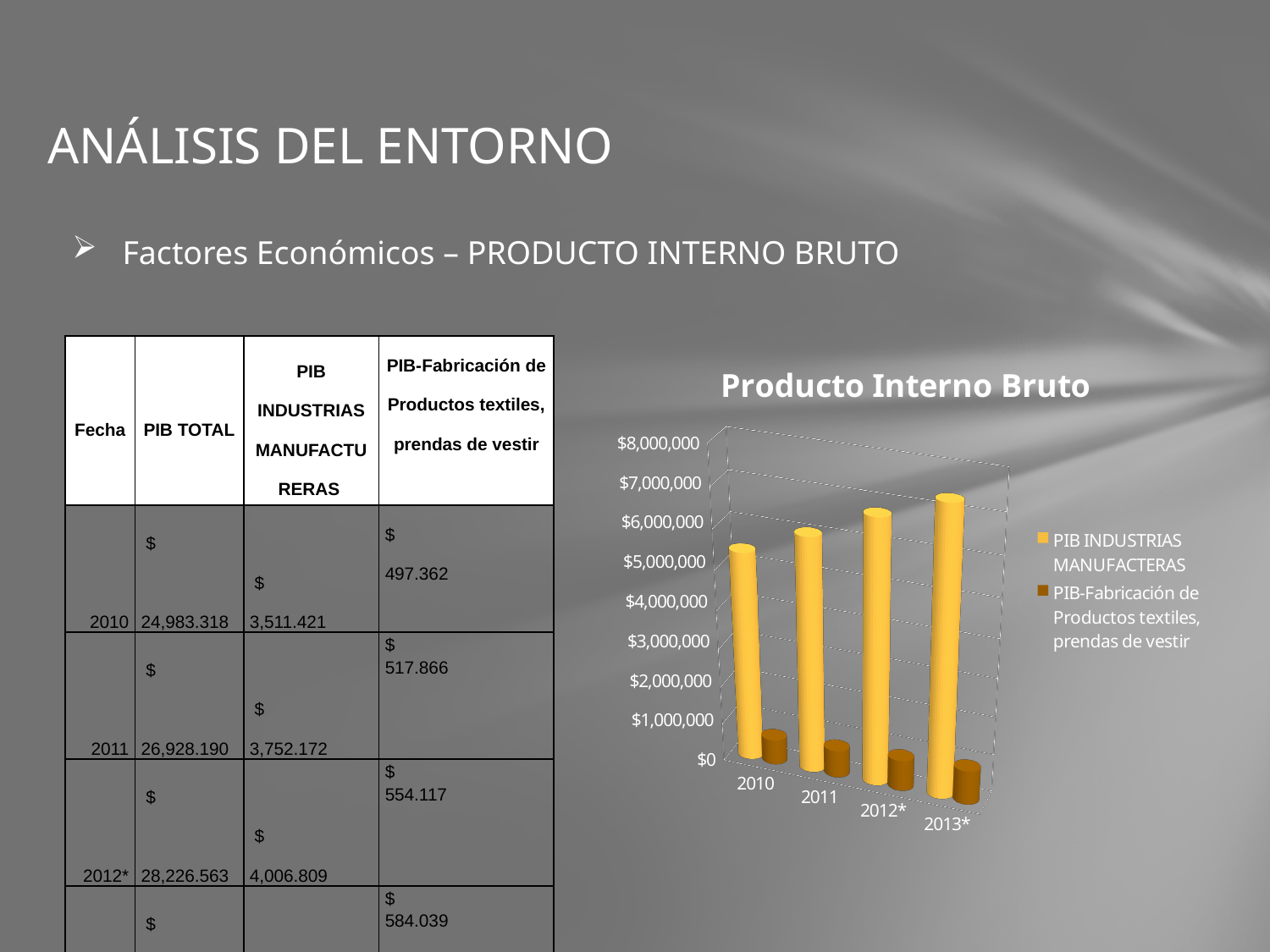
Is the value for PIB-Fabricación de Productos textiles, prendas de vestir in 2012* greater or less than $1,000,000? less Is the value for PIB INDUSTRIAS MANUFACTERAS in 2010 greater or less than $7,000,000? less Which year has the highest value for PIB INDUSTRIAS MANUFACTERAS in the chart? 2013* What kind of chart is shown on the slide? bar chart Is the value for PIB INDUSTRIAS MANUFACTERAS in 2013* greater or less than $5,000,000? greater What is the title of the chart on the slide? Producto Interno Bruto Do the PIB INDUSTRIAS MANUFACTERAS values rise or fall from 2010 to 2013* in the chart? rise In 2010, which series has the larger value in the chart: PIB INDUSTRIAS MANUFACTERAS or PIB-Fabricación de Productos textiles, prendas de vestir? PIB INDUSTRIAS MANUFACTERAS Which year has the lowest value for PIB INDUSTRIAS MANUFACTERAS in the chart? 2010 How many year categories are shown on the x axis of the chart? 4 How many series does the chart's legend list? 2 Which series is shown in the darker orange bars in the chart? PIB-Fabricación de Productos textiles, prendas de vestir